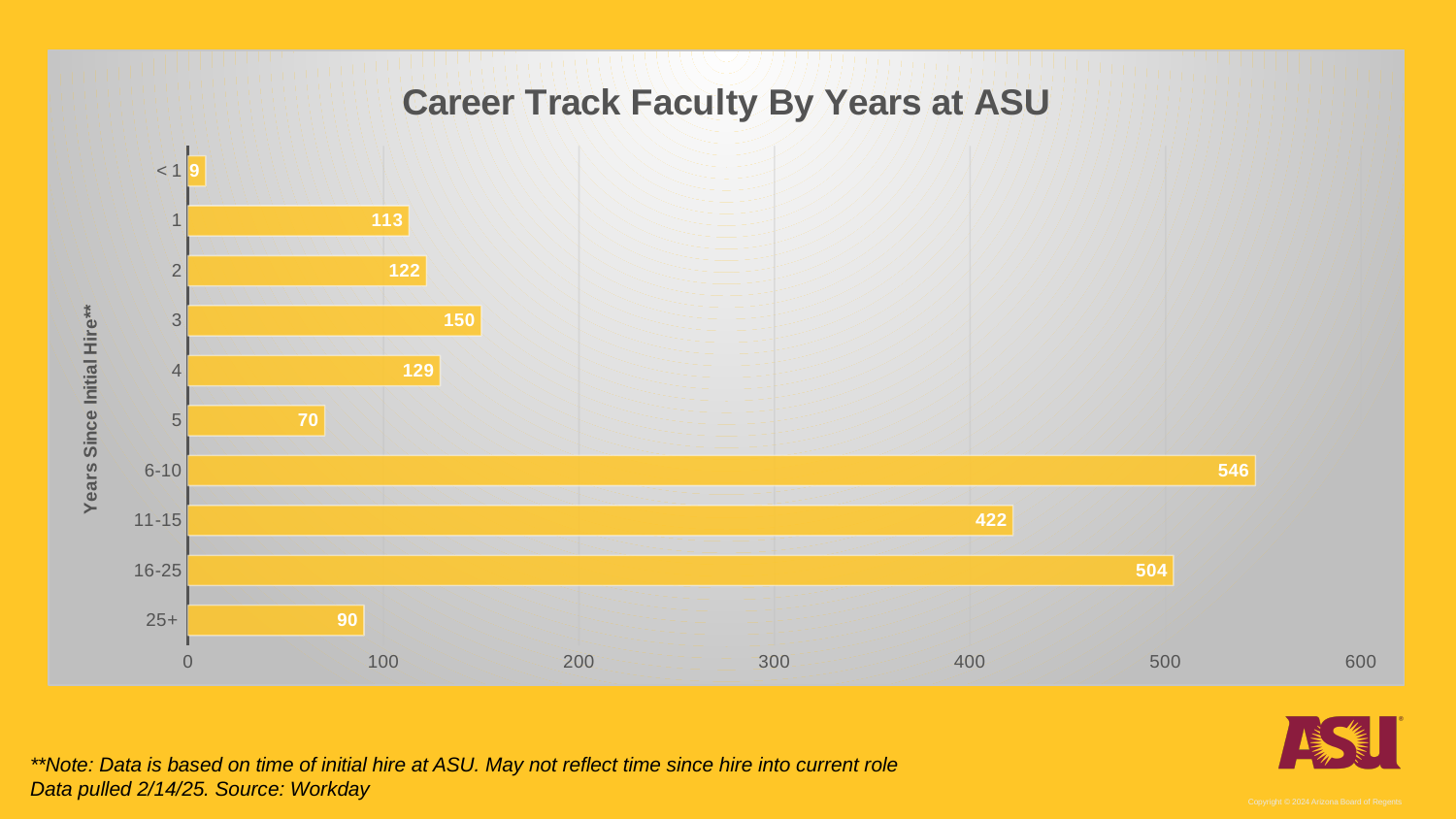
What is the value for the 3 years category? 150 Which category has the lowest value? < 1 What kind of chart is this? bar chart Is the value for 11-15 greater or less than 400? greater What is the title of the chart? Career Track Faculty By Years at ASU What is the difference between the values for 16-25 and 11-15? 82 What is the label of the vertical axis? Years Since Initial Hire** What is the value for the 25+ years category? 90 How many categories are shown on the chart? 10 Which is larger, the value for 2 years or the value for 4 years? 4 What is the value for the 6-10 years category? 546 Which category has the highest value? 6-10